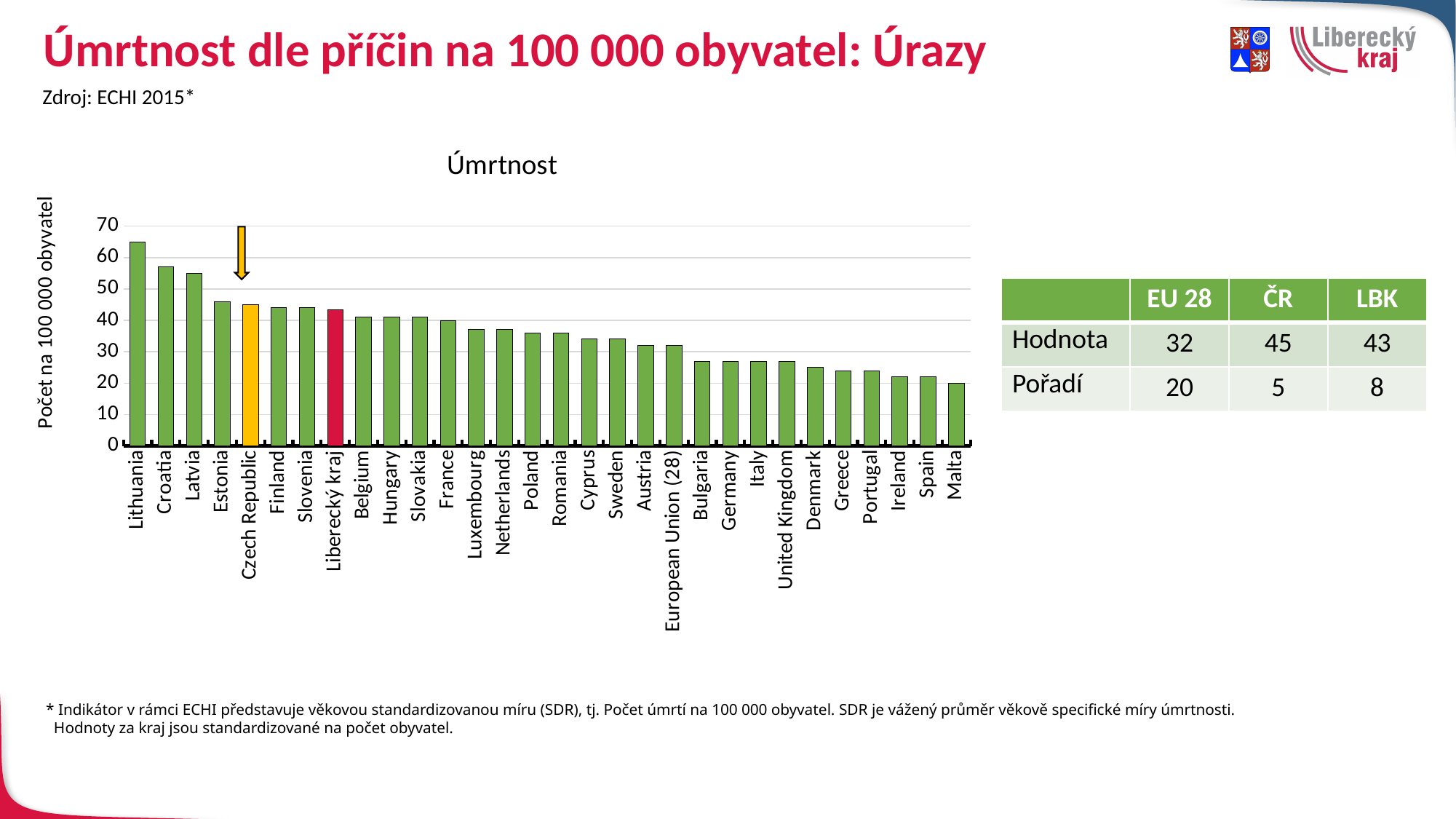
Which country has the highest value in the chart? Lithuania What type of chart is shown on the slide? bar chart What is the value for Liberecký kraj? 43 What is the difference between the values for Czech Republic and European Union (28)? 13 What is the value for Czech Republic? 45 What is the value for European Union (28)? 32 Which country has the lowest value in the chart? Malta Is the value for Malta greater or less than 30? less Which is larger, the value for Liberecký kraj or the value for European Union (28)? Liberecký kraj Do the values rise or fall from left to right along the x axis? fall How many countries or regions are shown in the chart? 30 Is the value for Lithuania greater or less than 60? greater